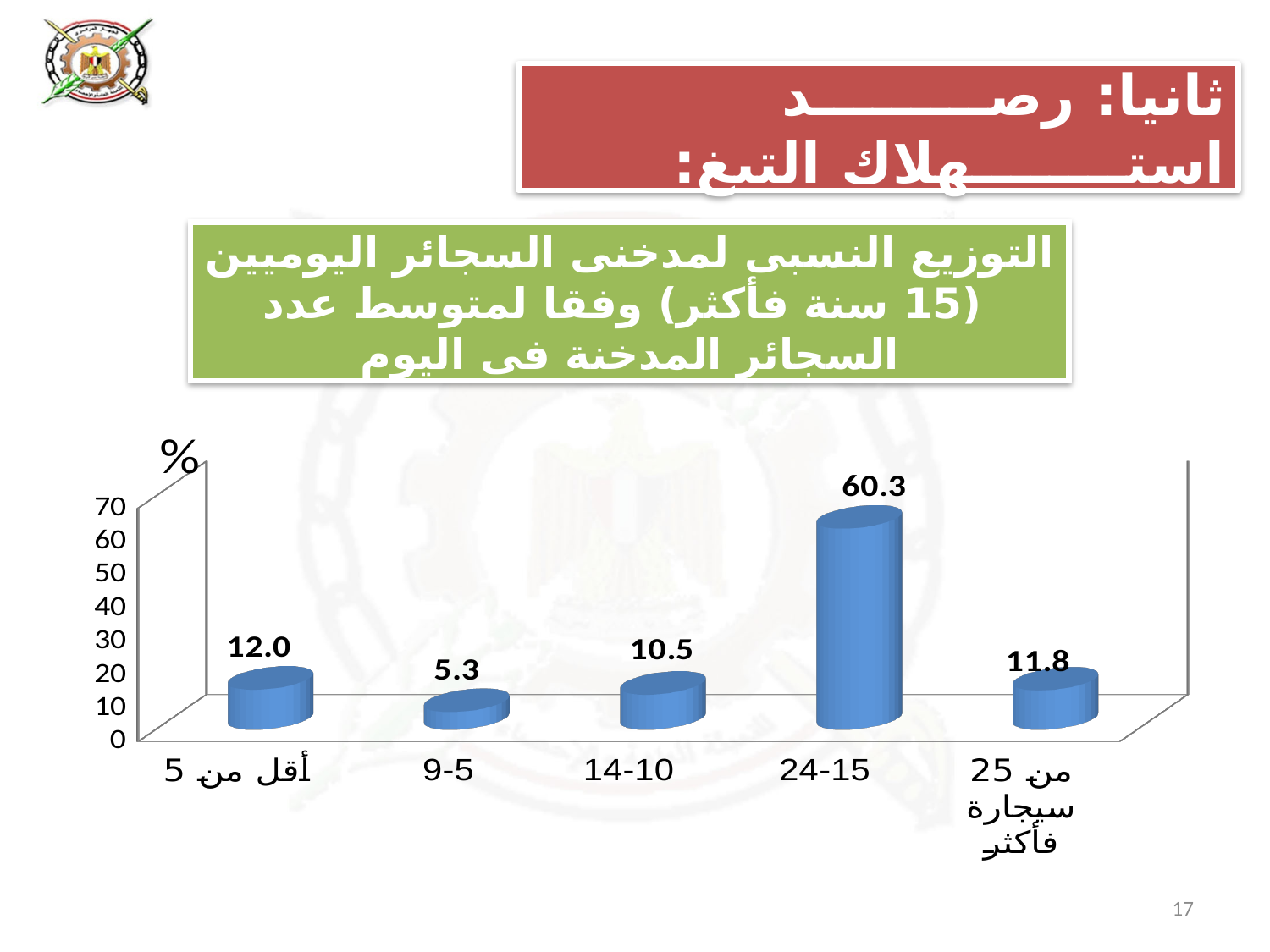
What is the value for the '25 سيجارة فأكثر' (25 cigarettes or more) category? 11.8 Which category has the lowest value? 9-5 Which is larger, the value for 'أقل من 5' or the value for 10-14? أقل من 5 How many categories are shown on the x axis? 5 What is the value for the 'أقل من 5' (less than 5) category? 12.0 Which category has the highest value? 24-15 What is the difference between the 15-24 category and the 10-14 category? 49.8 What kind of chart is shown on the slide? Bar chart What is the value for the 10-14 cigarettes category? 10.5 What is the value for the 5-9 cigarettes category? 5.3 What unit label is shown at the top of the vertical axis? % What is the value for the 15-24 cigarettes category? 60.3